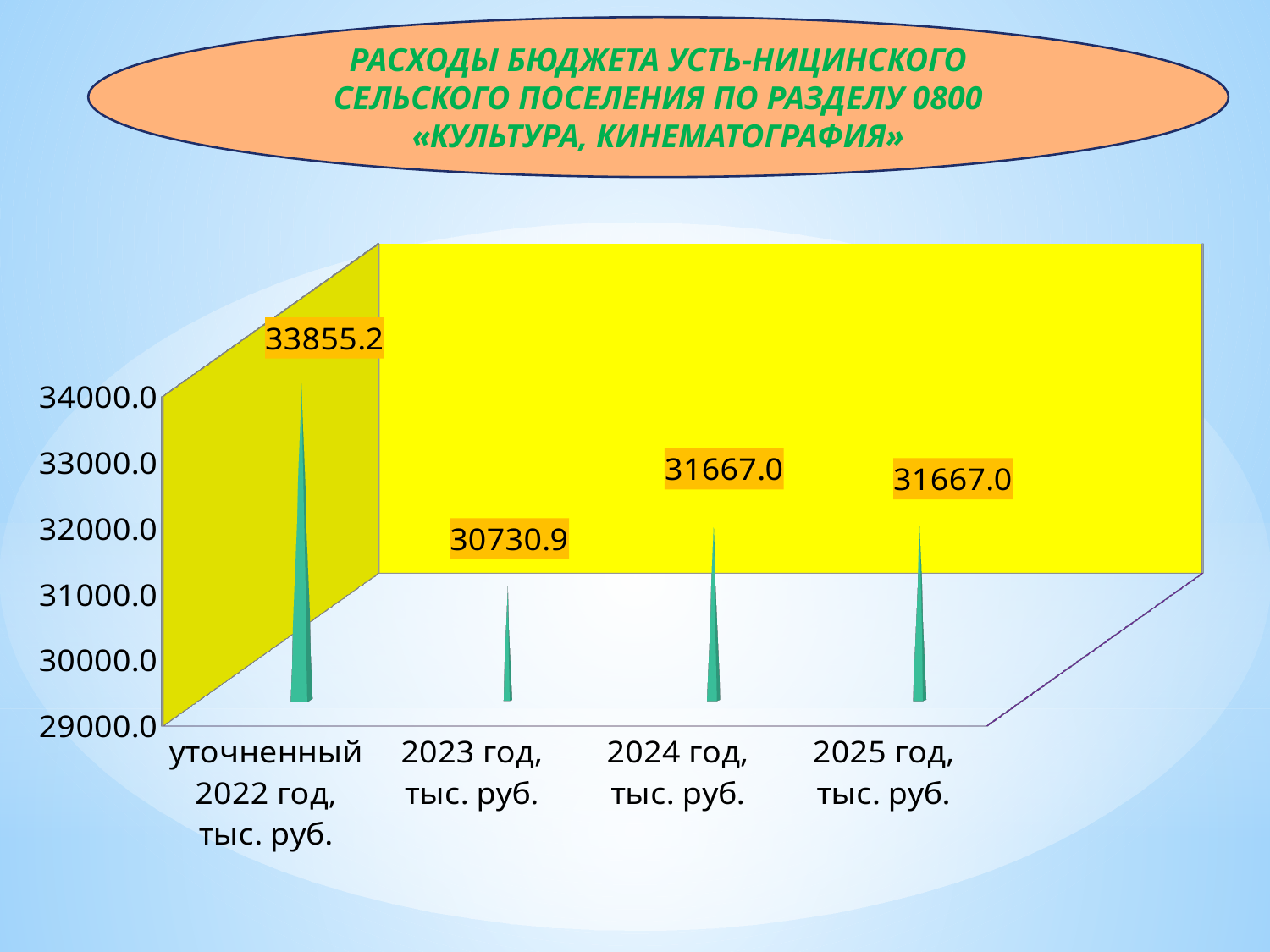
What is the difference between the values for уточненный 2022 год and 2023 год? 3124.3 What is the difference between the values for 2024 год and 2023 год? 936.1 How many categories are shown on the x axis? 4 Which category has the lowest value? 2023 год, тыс. руб. What is the value for 2025 год, тыс. руб.? 31667.0 Which is larger, the value for уточненный 2022 год or the value for 2024 год? уточненный 2022 год Which category has the highest value? уточненный 2022 год, тыс. руб. What kind of chart is shown on the slide? bar chart What is the value for уточненный 2022 год, тыс. руб.? 33855.2 What is the value for 2024 год, тыс. руб.? 31667.0 Is the value for 2023 год greater or less than 31000.0? less What is the value for 2023 год, тыс. руб.? 30730.9